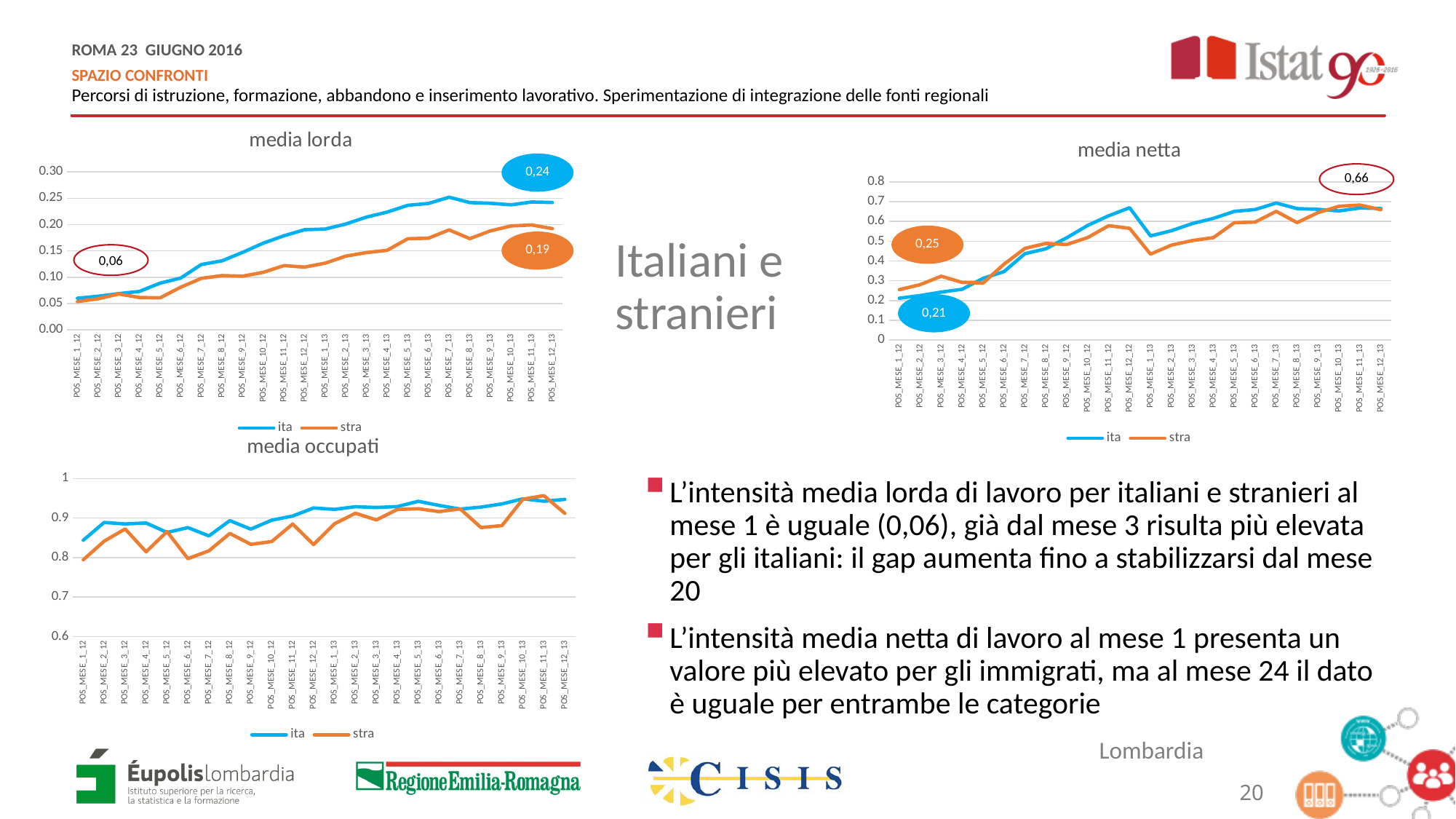
What kind of chart is the "media lorda" chart? line chart In the "media netta" chart, what value is annotated for the stra series at the first month? 0,25 In the "media lorda" chart, what is the difference between the annotated final values of ita (0,24) and stra (0,19)? 0,05 In the "media lorda" chart, what value is annotated for the stra series at the last month (POS_MESE_12_13)? 0,19 In the "media lorda" chart, does the ita series generally rise or fall from POS_MESE_1_12 to POS_MESE_12_13? rise In the "media lorda" chart, what value is annotated for the ita series at the last month (POS_MESE_12_13)? 0,24 In the "media netta" chart, what value is annotated at the last month (POS_MESE_12_13)? 0,66 In the "media netta" chart, what value is annotated for the ita series at the first month? 0,21 How many series does the legend of the "media netta" chart list? 2 In the "media lorda" chart, what value is annotated at the first month (POS_MESE_1_12)? 0,06 How many months (categories) are plotted on the x axis of the "media occupati" chart? 24